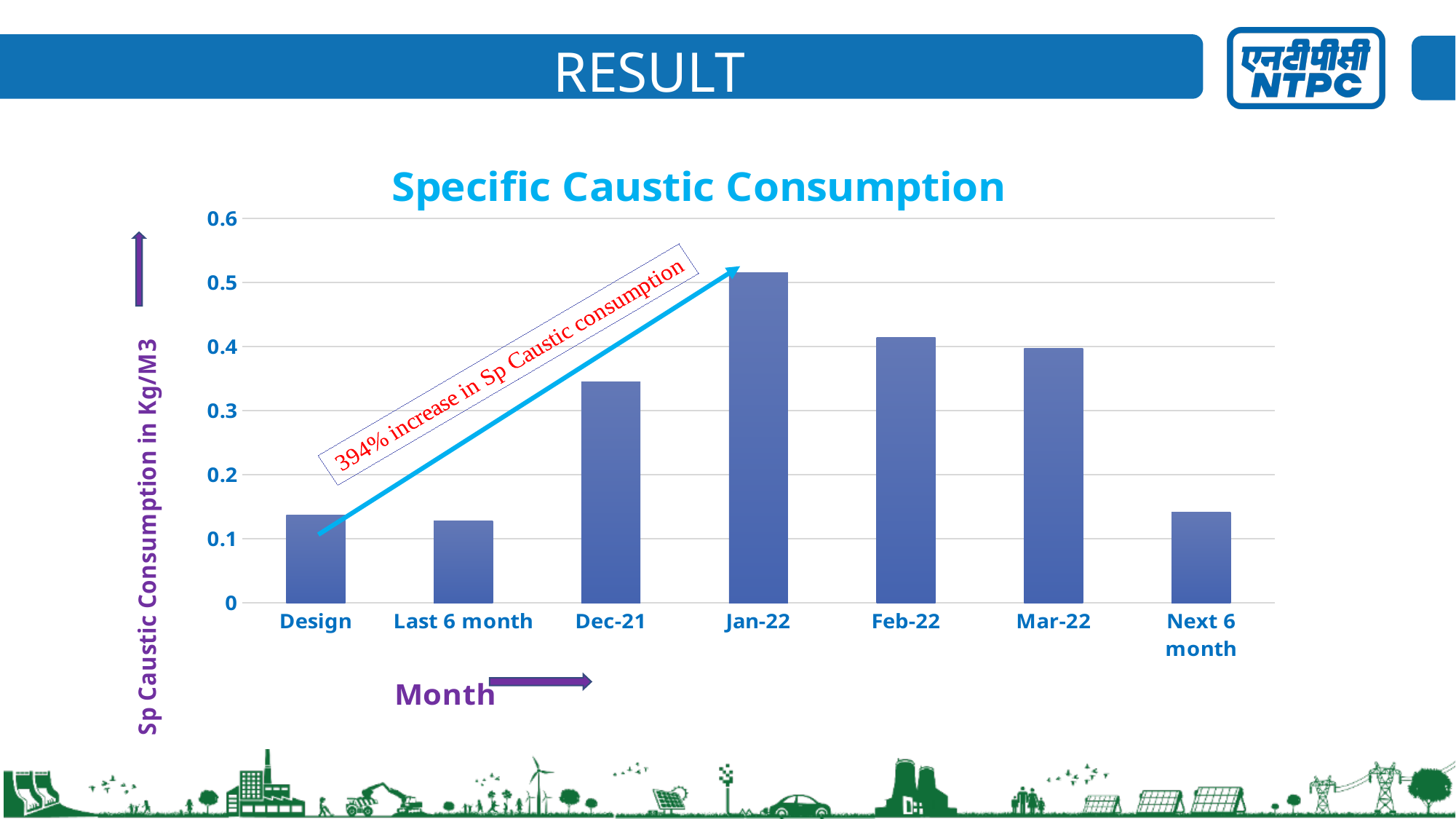
What kind of chart is shown on the slide? bar chart Which category has the highest Specific Caustic Consumption? Jan-22 Which is larger, the value for Jan-22 or the value for Dec-21? Jan-22 Is the value for Next 6 month greater or less than 0.3? less Is the value for Dec-21 greater or less than 0.3? greater Is the value for Mar-22 greater or less than 0.3? greater Do the values rise or fall from Jan-22 to Mar-22? fall Which is larger, the value for Feb-22 or the value for Dec-21? Feb-22 How many categories are plotted on the x axis of the Specific Caustic Consumption chart? 7 What is the label on the y axis of the chart? Sp Caustic Consumption in Kg/M3